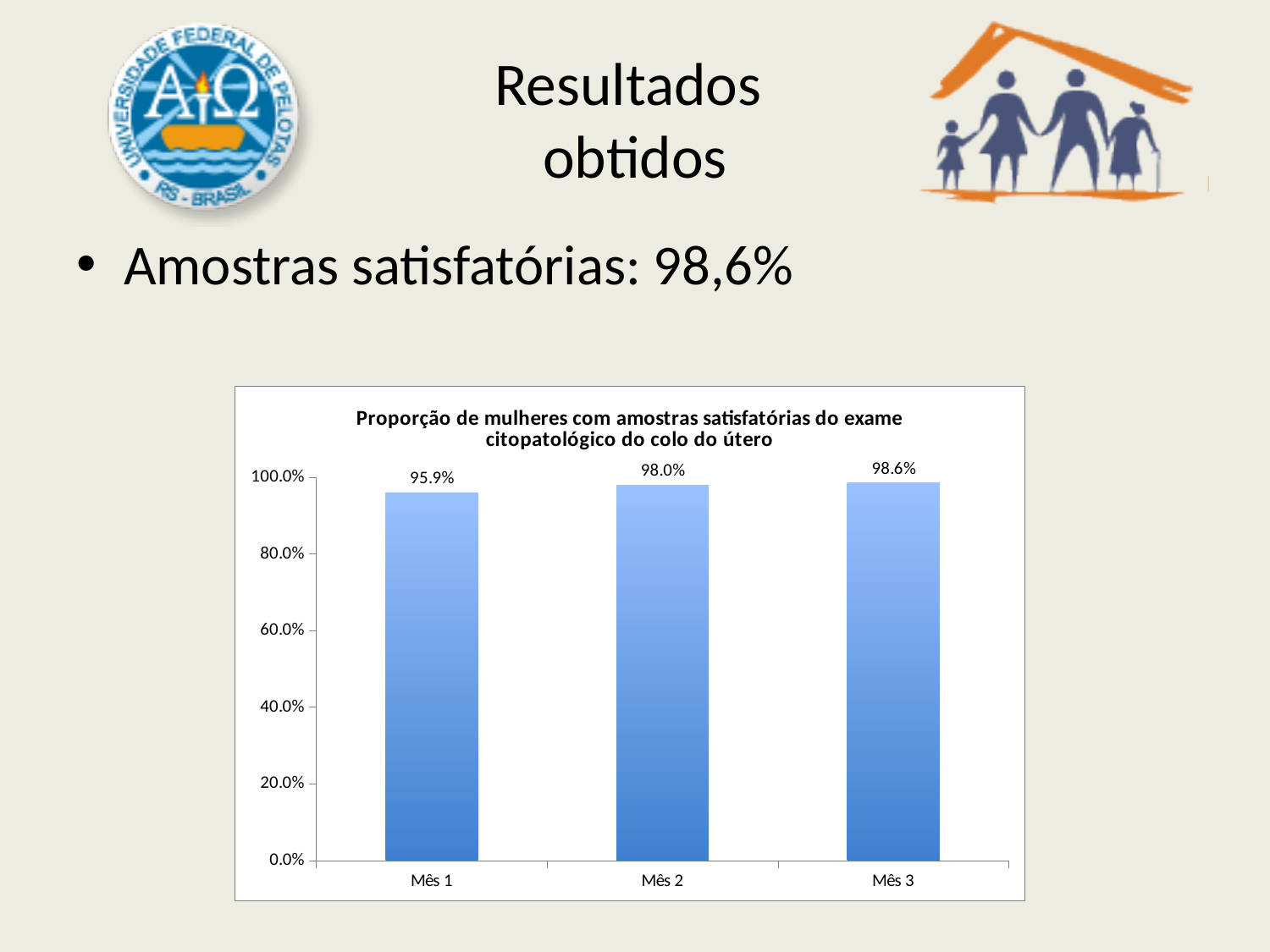
What is the difference between the values for Mês 2 and Mês 1? 2.1% Do the values rise or fall from Mês 1 to Mês 3? Rise How many months are shown on the x axis? 3 What is the difference between the values for Mês 3 and Mês 1? 2.7% What is the value for Mês 1? 95.9% Which month has the highest proportion? Mês 3 What is the value for Mês 3? 98.6% Which is larger, the value for Mês 1 or the value for Mês 2? Mês 2 Which month has the lowest proportion? Mês 1 What is the title of the chart? Proporção de mulheres com amostras satisfatórias do exame citopatológico do colo do útero What kind of chart is shown on the slide? Bar chart What is the value for Mês 2? 98.0%